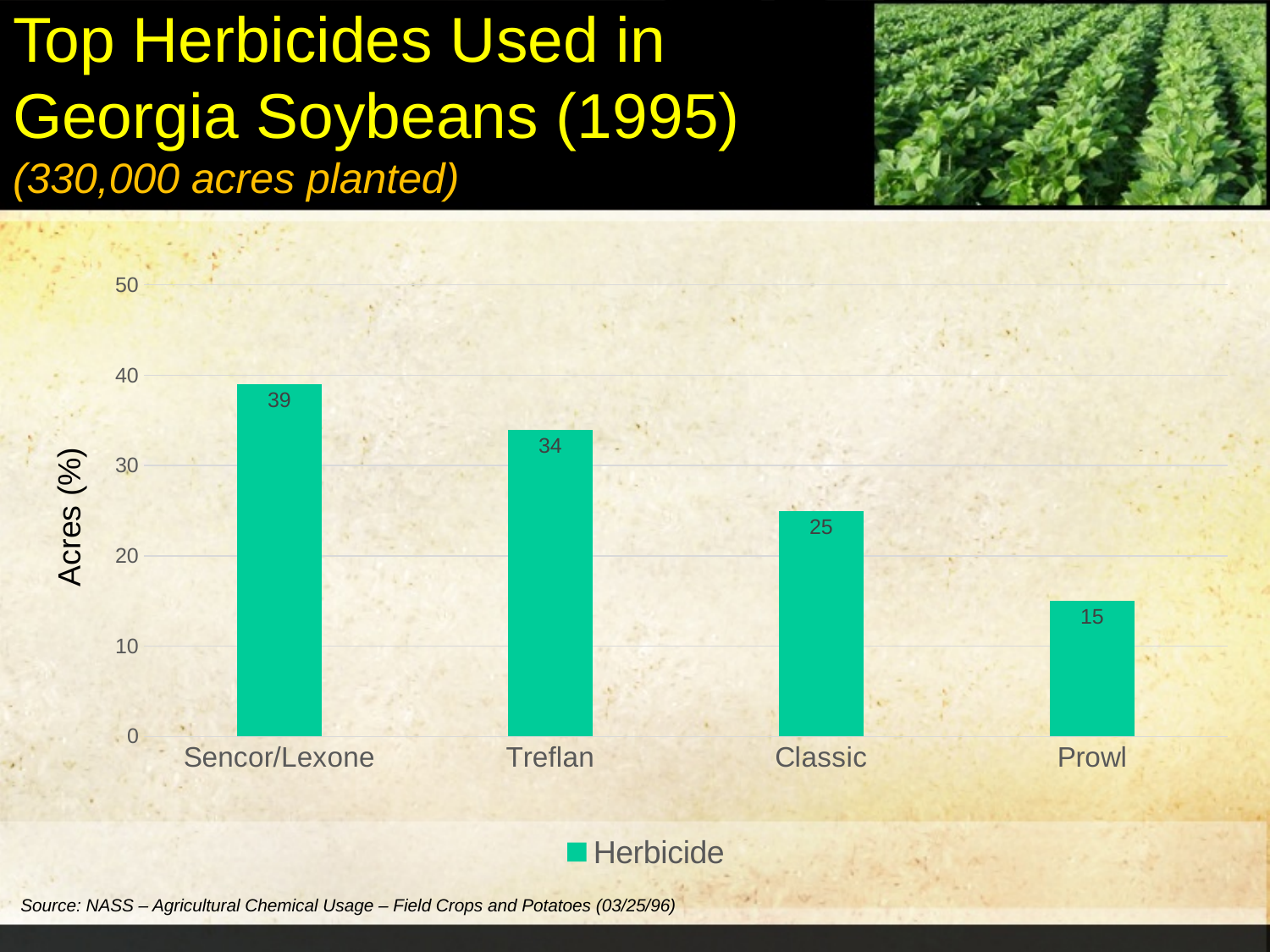
What kind of chart is shown on the slide? Bar chart How many herbicides are shown on the chart? 4 Which is larger, the value for Treflan or the value for Classic? Treflan What is the difference between the values for Sencor/Lexone and Prowl? 24 What is the difference between the values for Treflan and Classic? 9 What is the label of the y axis? Acres (%) Which herbicide has the lowest value? Prowl What is the value for Sencor/Lexone? 39 What is the value for Prowl? 15 What is the value for Treflan? 34 What is the value for Classic? 25 Which herbicide has the highest value? Sencor/Lexone